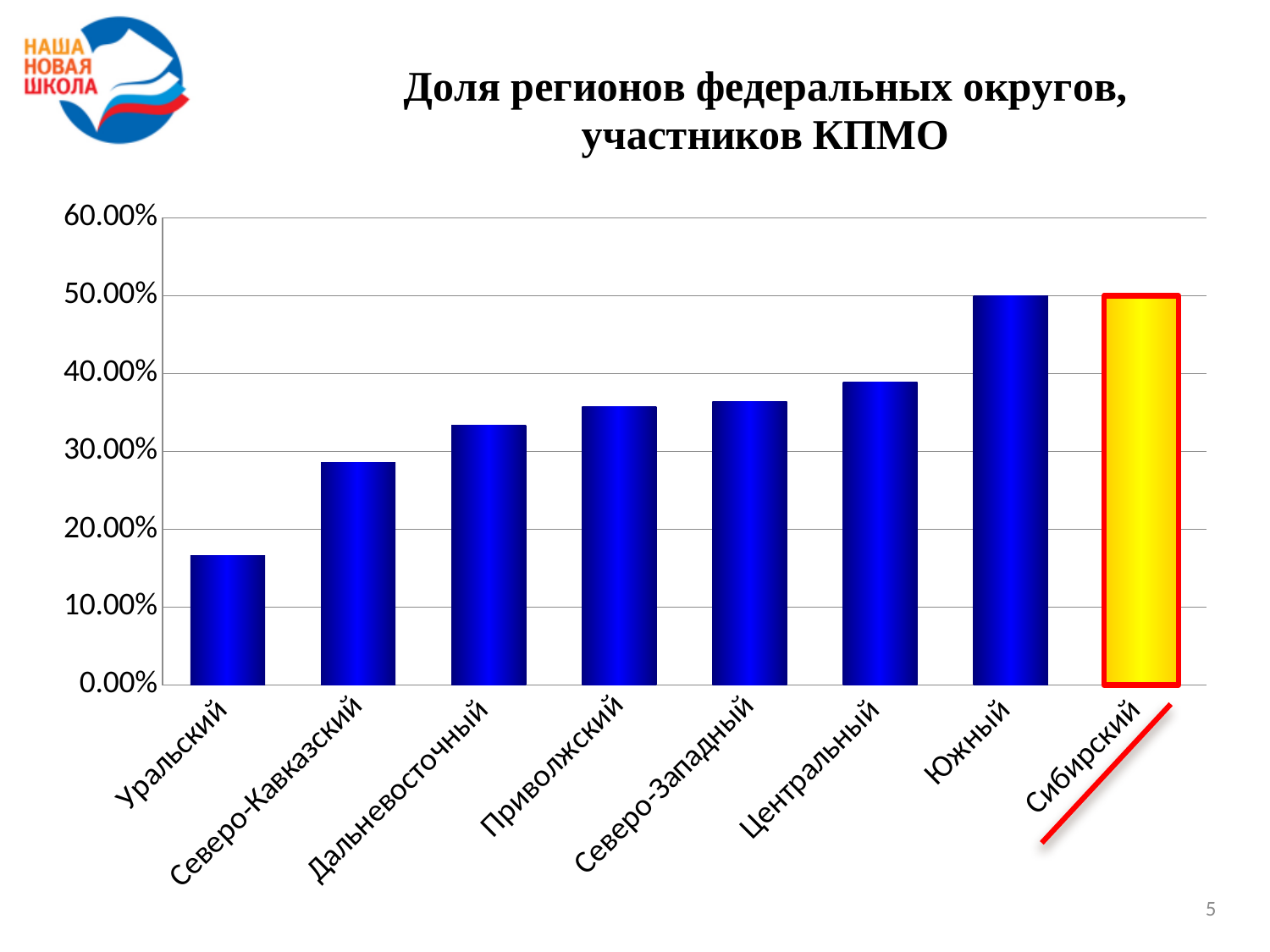
How many federal districts (categories) are shown on the x axis? 8 Which federal district's bar is highlighted in yellow with a red outline? Сибирский Which federal district has the lowest share? Уральский Is the value for Северо-Кавказский greater or less than 30.00%? less What is the title of the chart? Доля регионов федеральных округов, участников КПМО Is the value for Центральный greater or less than 40.00%? less Which is larger, the value for Центральный or the value for Северо-Кавказский? Центральный What kind of chart is shown on the slide? bar chart Is the value for Дальневосточный greater or less than 30.00%? greater Do the values generally rise or fall from left to right along the x axis? rise